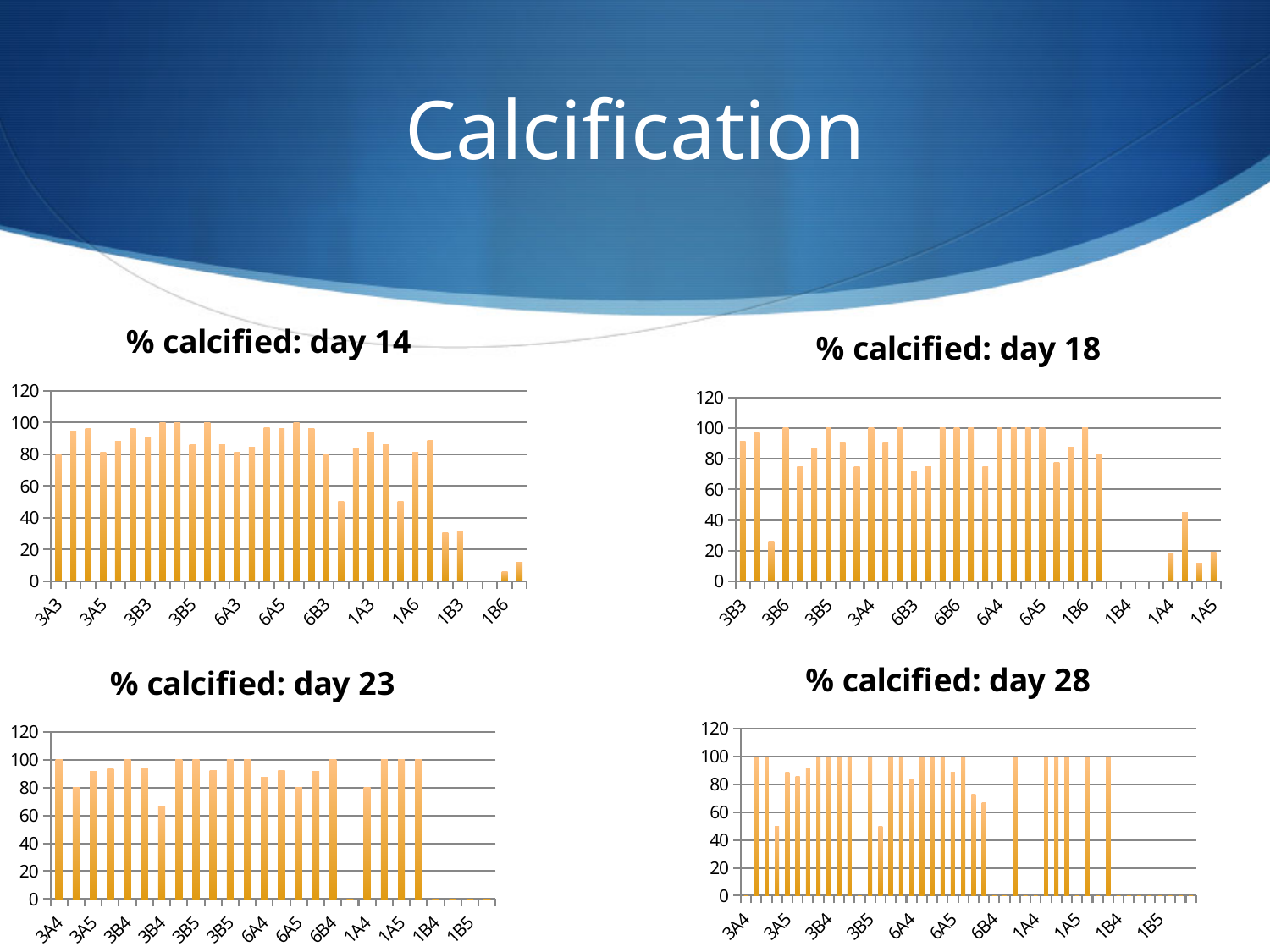
In the "% calcified: day 14" chart, is the value for 3A5 greater or less than 60? greater What kind of chart is "% calcified: day 14"? bar chart In the "% calcified: day 23" chart, is the value for 1B5 greater or less than 20? less In the "% calcified: day 18" chart, is the value for 3B3 greater or less than 60? greater How many charts are shown on the slide? 4 What is the highest value shown on the vertical axis of the "% calcified: day 23" chart? 120 In the "% calcified: day 14" chart, do the values generally rise or fall from left to right along the x axis? fall What is the title of the chart in the bottom-right of the slide? % calcified: day 28